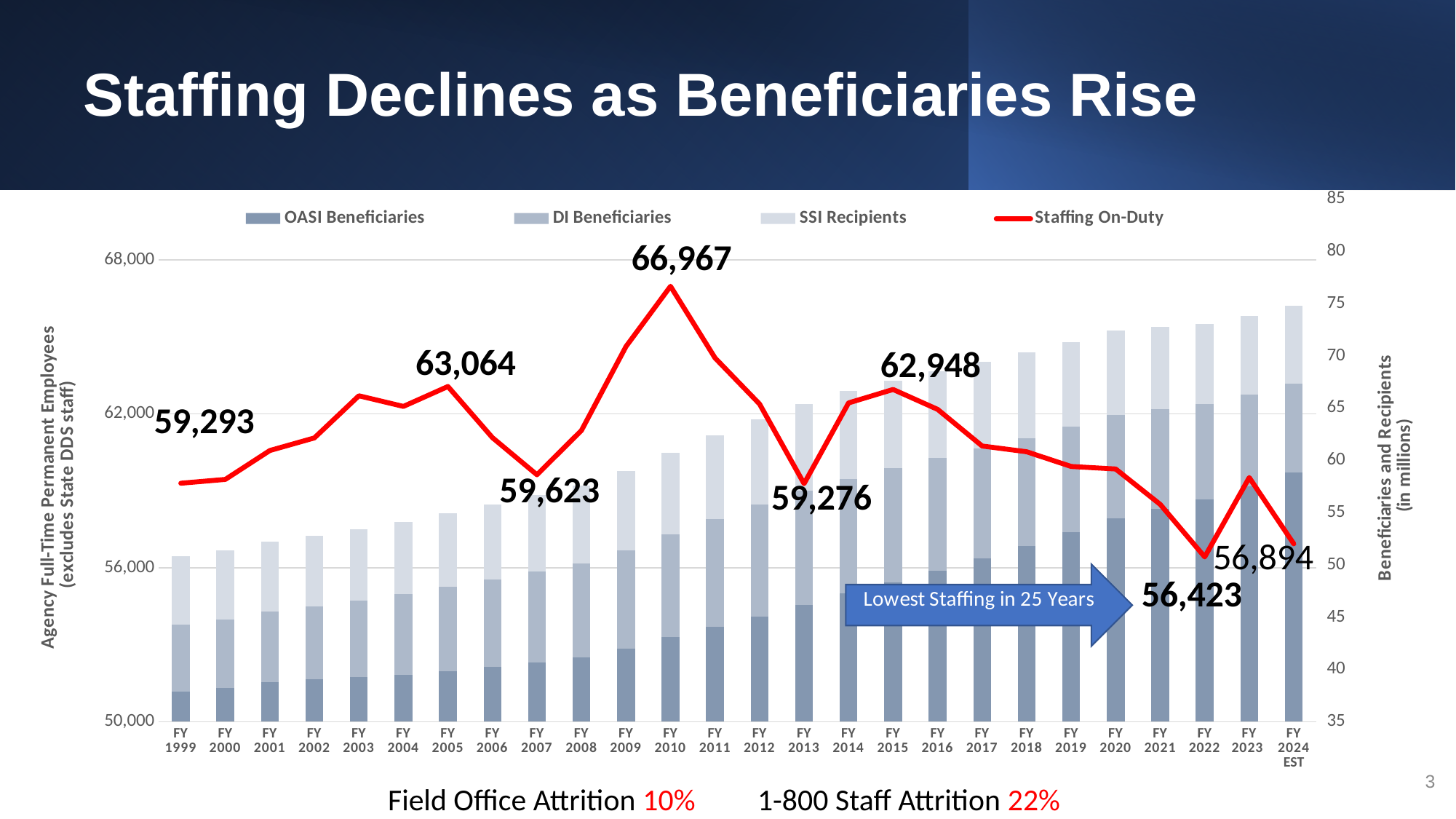
How many fiscal years are shown on the x axis? 26 In which fiscal year does the Staffing On-Duty line reach its lowest point? FY 2022 Which is larger, the Staffing On-Duty value for FY 2005 or for FY 2015? FY 2005 What is the Staffing On-Duty value labeled for FY 2010? 66,967 What is the difference between the Staffing On-Duty values for FY 2010 and FY 2022? 10,544 Does the Staffing On-Duty line rise or fall from FY 2015 to FY 2022? fall Is the total beneficiaries and recipients bar for FY 2024 EST greater or less than 70 on the right axis? greater How many series does the legend list? 4 What is the Staffing On-Duty value labeled for FY 2022? 56,423 What is the Staffing On-Duty value labeled for FY 1999? 59,293 In which fiscal year does the Staffing On-Duty line reach its highest point? FY 2010